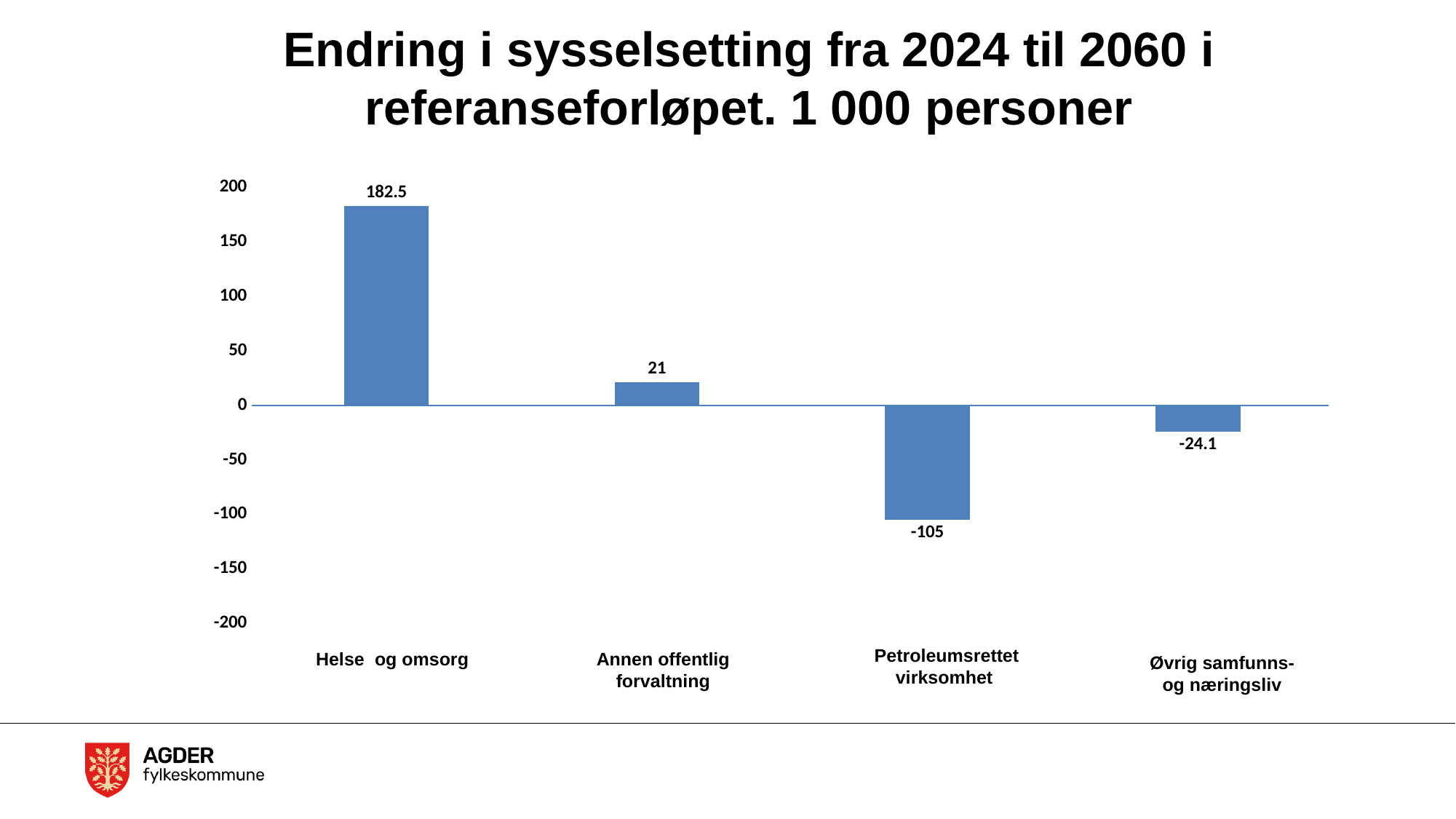
How many categories are shown on the x axis? 4 Which category has the lowest value? Petroleumsrettet virksomhet What is the value for Øvrig samfunns- og næringsliv? -24.1 Which is larger, the value for Annen offentlig forvaltning or the value for Øvrig samfunns- og næringsliv? Annen offentlig forvaltning Is the value for Helse og omsorg greater or less than 150? greater Which category has the highest value? Helse og omsorg What kind of chart is shown on the slide? Bar chart What is the value for Petroleumsrettet virksomhet? -105 What is the difference between the values for Helse og omsorg and Annen offentlig forvaltning? 161.5 What is the title of the chart? Endring i sysselsetting fra 2024 til 2060 i referanseforløpet. 1 000 personer What is the value for Helse og omsorg? 182.5 What is the value for Annen offentlig forvaltning? 21